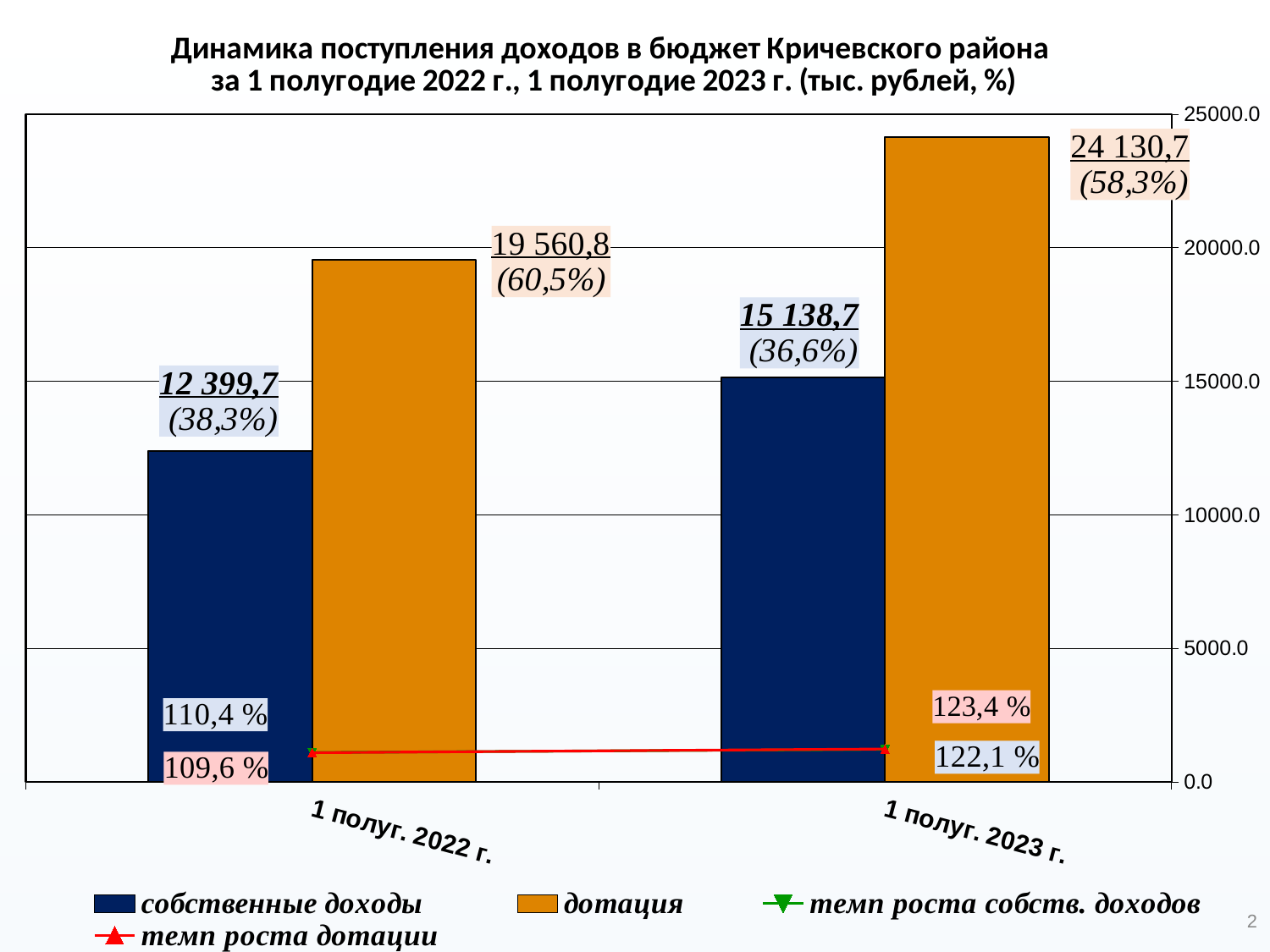
Which bar is the tallest on the chart? дотация, 1 полуг. 2023 г. By how much did дотация increase from 1 полуг. 2022 г. to 1 полуг. 2023 г.? 4 569,9 What is the value of собственные доходы for 1 полуг. 2022 г.? 12 399,7 Is the value of собственные доходы for 1 полуг. 2023 г. greater or less than 15000.0? greater What is the value of дотация for 1 полуг. 2022 г.? 19 560,8 Which bar is the lowest on the chart? собственные доходы, 1 полуг. 2022 г. What share (in parentheses) is shown for дотация in 1 полуг. 2022 г.? 60,5% What is the difference between дотация and собственные доходы in 1 полуг. 2023 г.? 8 992,0 What is the value of дотация for 1 полуг. 2023 г.? 24 130,7 Do the собственные доходы values rise or fall from 1 полуг. 2022 г. to 1 полуг. 2023 г.? rise What is the value of собственные доходы for 1 полуг. 2023 г.? 15 138,7 How many series does the legend list? 4